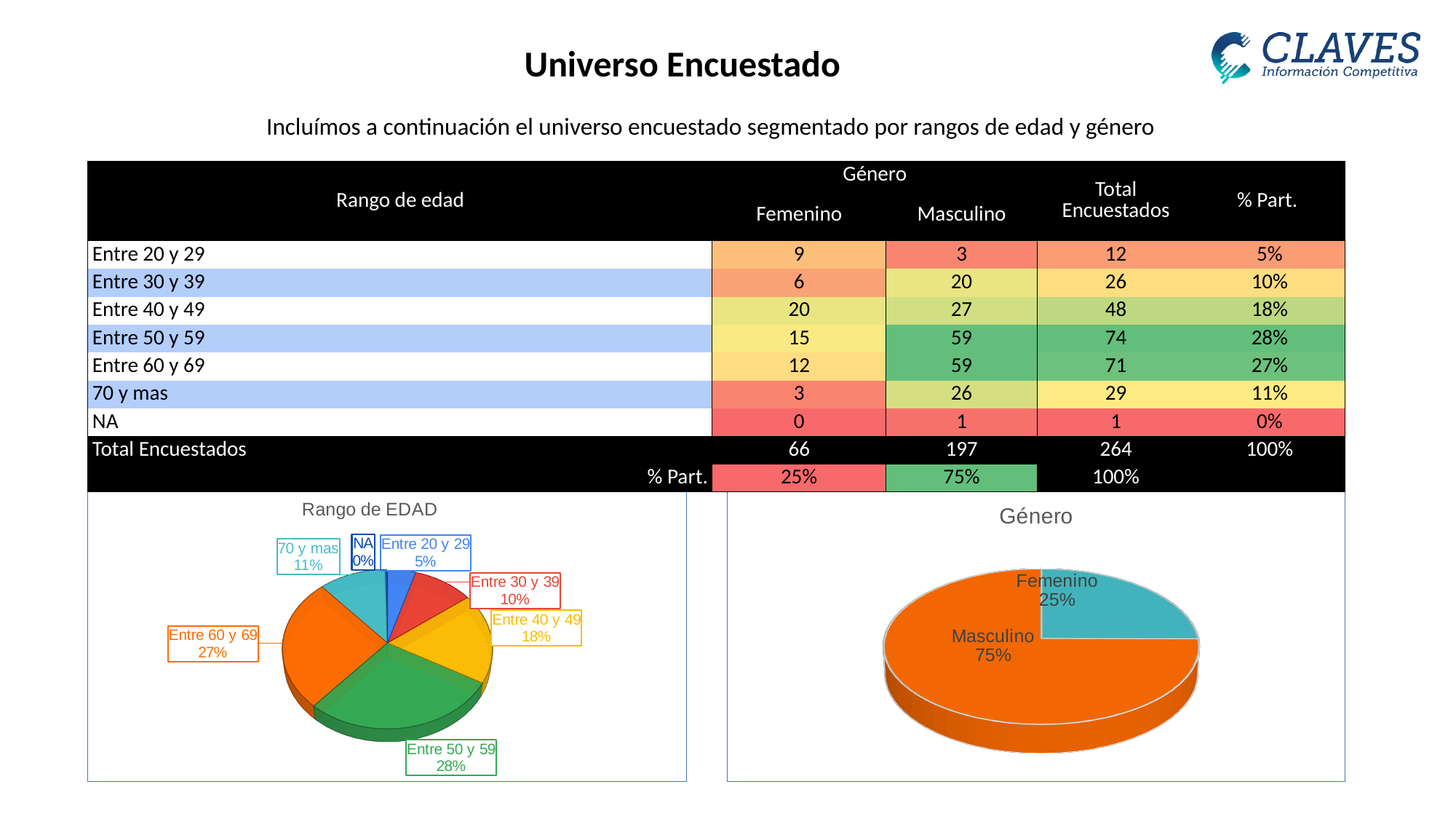
In the 'Rango de EDAD' chart, which category has the largest share? Entre 50 y 59 In the 'Rango de EDAD' chart, what is the value shown for '70 y mas'? 11% In the 'Rango de EDAD' chart, what is the difference between the shares of 'Entre 40 y 49' and 'Entre 30 y 39'? 8% In the 'Rango de EDAD' chart, which labelled category has the smallest share? NA In the 'Rango de EDAD' chart, which is larger: 'Entre 20 y 29' or '70 y mas'? 70 y mas What kind of chart is the 'Género' chart? Pie chart In the 'Rango de EDAD' chart, what share of the pie does 'Entre 60 y 69' have? 27% In the 'Rango de EDAD' chart, what share of the pie does 'Entre 50 y 59' have? 28% How many categories are shown in the 'Rango de EDAD' chart? 7 In the 'Género' chart, what share of the pie is 'Masculino'? 75% In the 'Rango de EDAD' chart, what is the value shown for 'Entre 40 y 49'? 18% In the 'Género' chart, what is the difference between the 'Masculino' and 'Femenino' shares? 50%